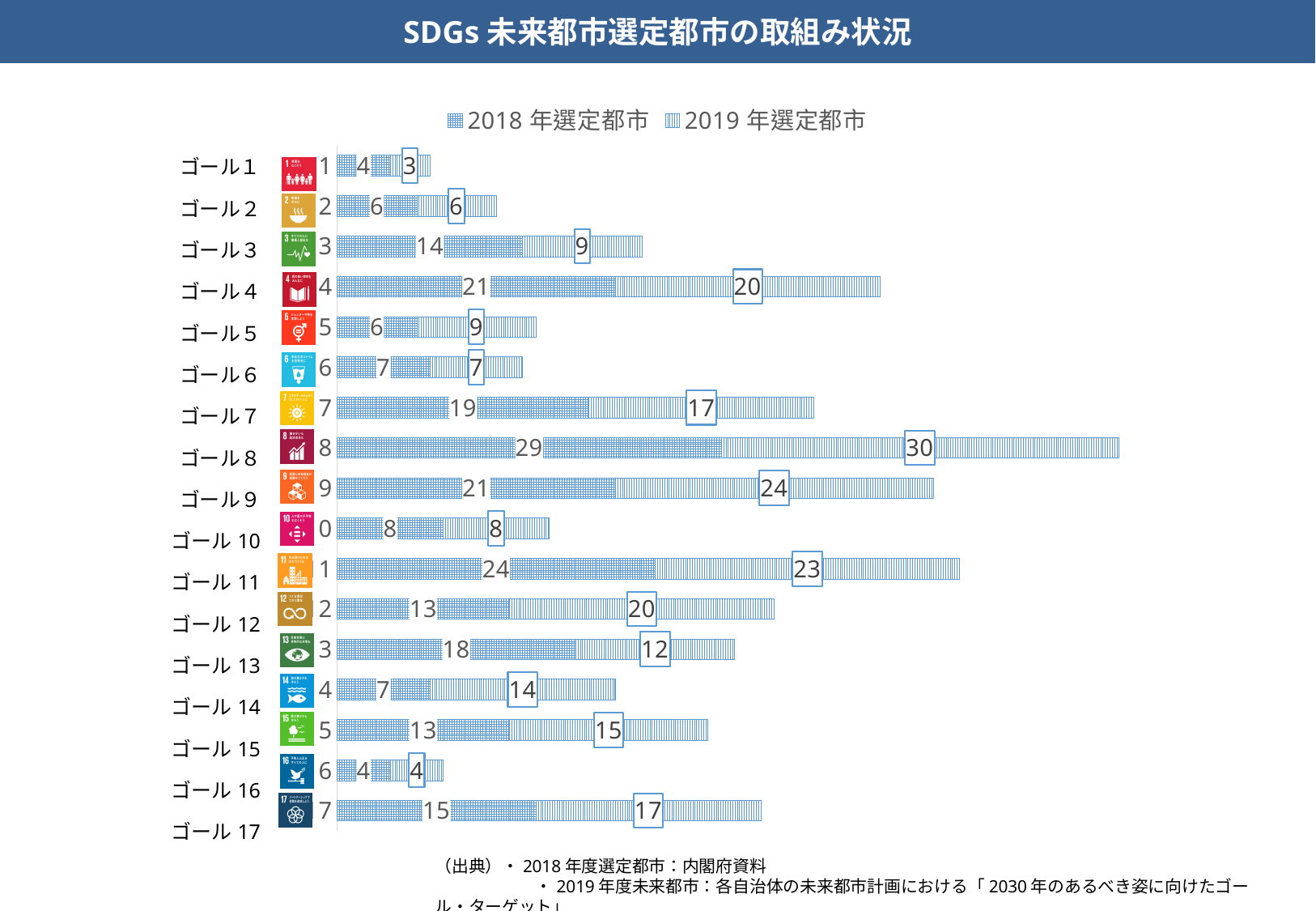
How many goal categories are plotted on the chart? 17 For ゴール 13, which series has the larger value, 2018年選定都市 or 2019年選定都市? 2018年選定都市 What kind of chart is shown on the slide? bar chart What is the title of the chart on the slide? SDGs未来都市選定都市の取組み状況 How many series does the legend list? 2 What is the value for ゴール 4 in the 2019年選定都市 series? 20 Which goal has the lowest value in the 2019年選定都市 series? ゴール 1 What is the value for ゴール 14 in the 2019年選定都市 series? 14 What is the difference between the 2018年選定都市 and 2019年選定都市 values for ゴール 12? 7 What is the value for ゴール 8 in the 2018年選定都市 series? 29 Which goal has the highest value in the 2019年選定都市 series? ゴール 8 What is the difference between the 2018年選定都市 values for ゴール 11 and ゴール 3? 10